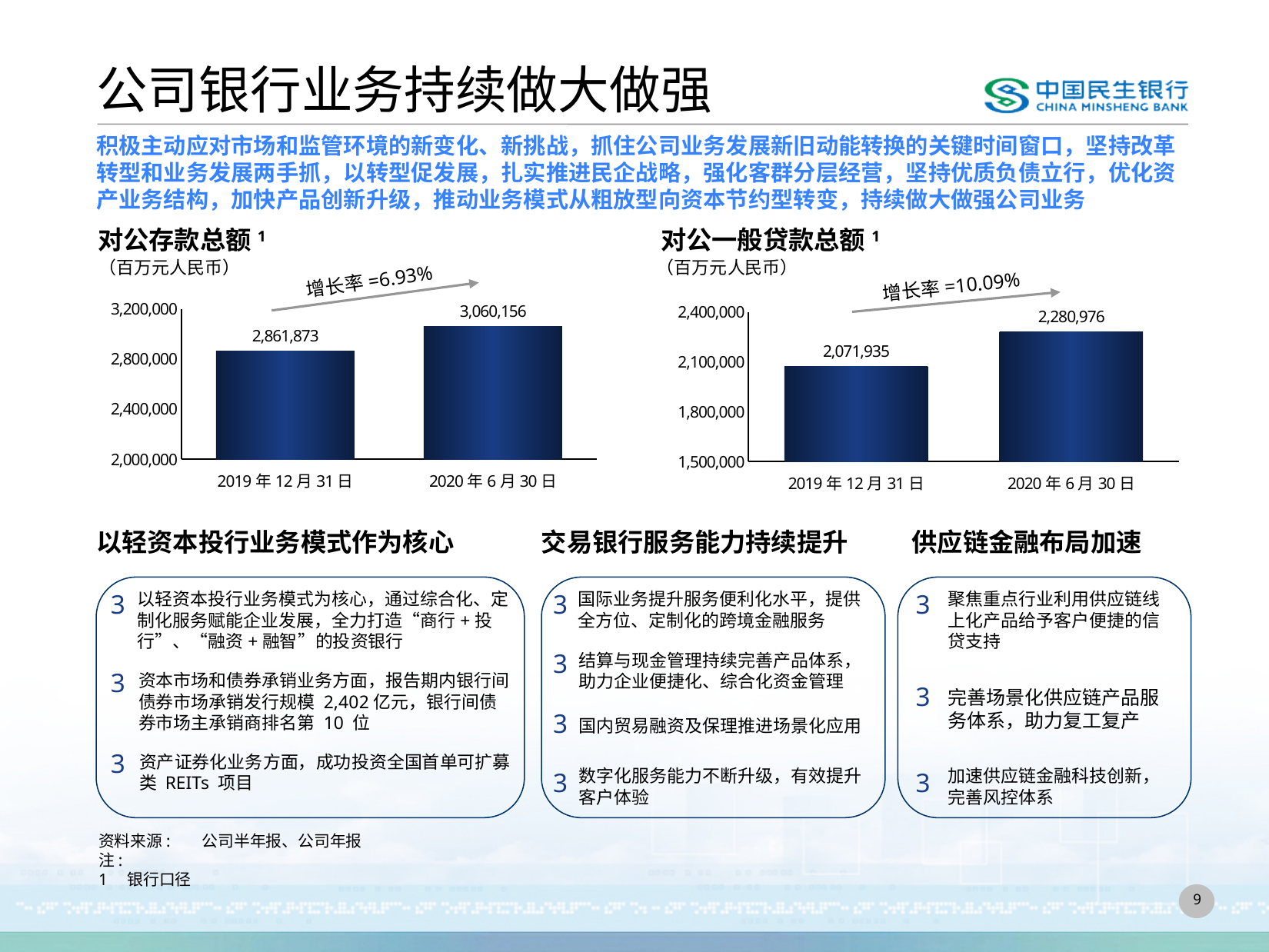
In the 对公存款总额 chart, which date has the higher value? 2020年6月30日 What kind of chart is the 对公一般贷款总额 chart? Bar chart How many bars are in the 对公一般贷款总额 chart? 2 In the 对公存款总额 chart, what is the difference between the 2020年6月30日 value and the 2019年12月31日 value? 198,283 In the 对公一般贷款总额 chart, what is the value for 2019年12月31日? 2,071,935 In the 对公一般贷款总额 chart, which date has the lower value? 2019年12月31日 In the 对公存款总额 chart, do the values rise or fall from 2019年12月31日 to 2020年6月30日? Rise In the 对公一般贷款总额 chart, what is the difference between the 2020年6月30日 value and the 2019年12月31日 value? 209,041 In the 对公一般贷款总额 chart, what is the value for 2020年6月30日? 2,280,976 What growth rate (增长率) is shown on the 对公一般贷款总额 chart? 10.09% In the 对公存款总额 chart, what is the value for 2019年12月31日? 2,861,873 In the 对公存款总额 chart, what is the value for 2020年6月30日? 3,060,156